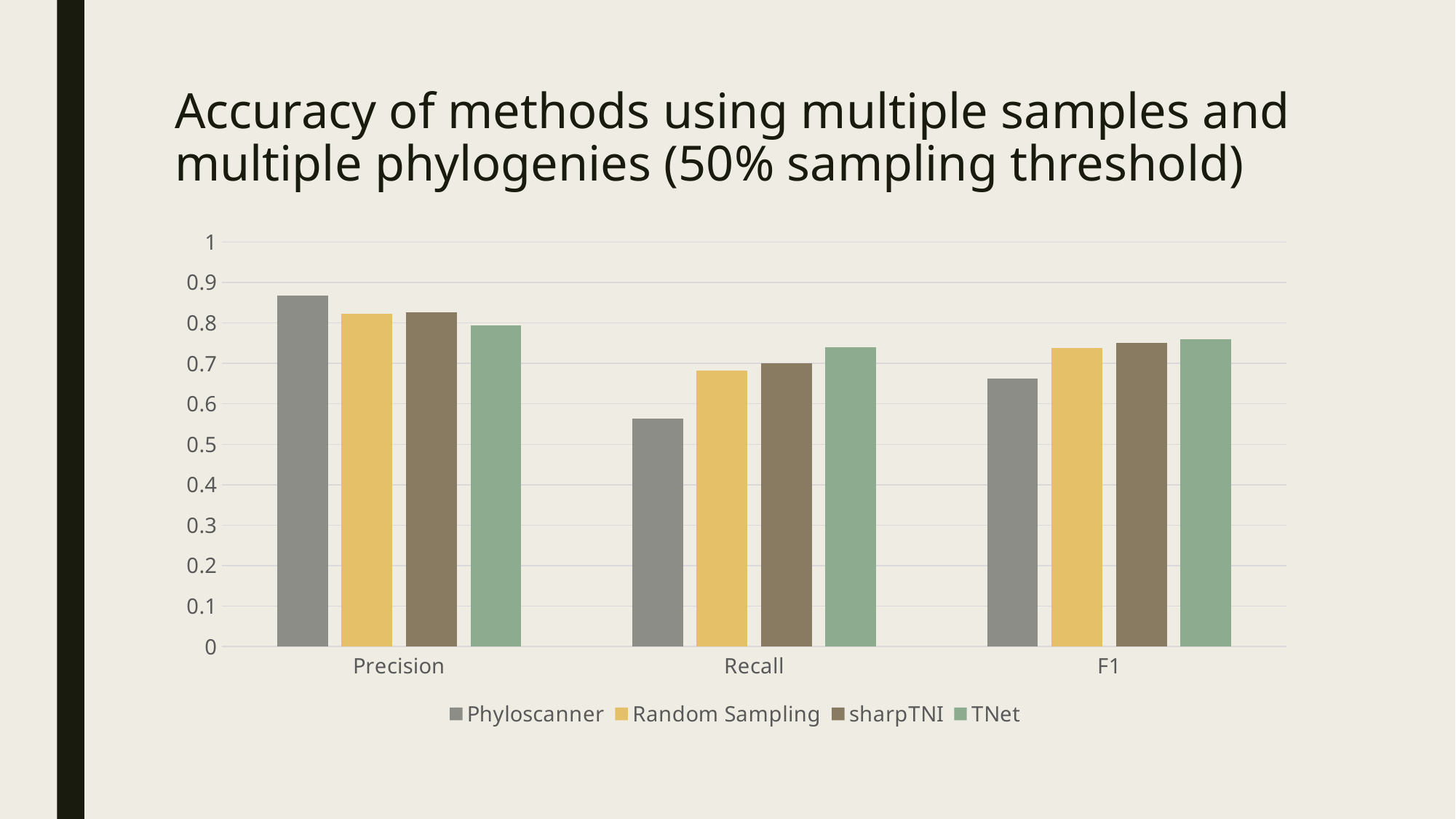
Is the Precision value for Phyloscanner greater or less than 0.8? greater What kind of chart is shown on the slide? bar chart Which colour represents TNet in the legend? green Which method has the lowest F1? Phyloscanner Is the Recall value for Phyloscanner greater or less than 0.6? less How many categories are shown on the x axis? 3 Which is larger for Phyloscanner: its Precision or its Recall? Precision How many series does the legend list? 4 Which method has the lowest Recall? Phyloscanner Which method has the highest Recall? TNet Is the Recall value for TNet greater or less than 0.7? greater Which method has the highest Precision? Phyloscanner